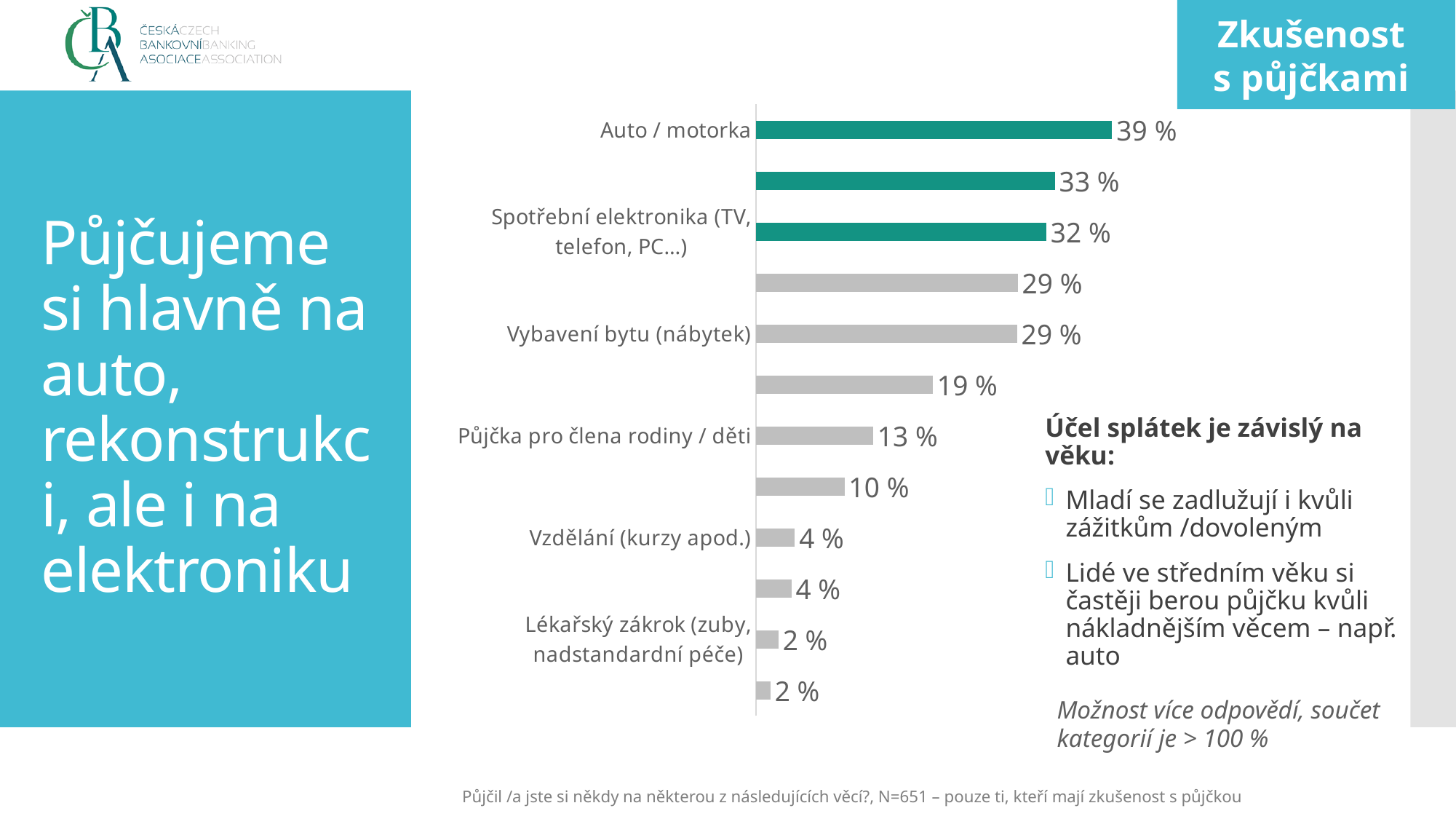
What is the value for Vzdělání (kurzy apod.)? 4 % How many bars are plotted in the chart? 12 How many bars are coloured teal rather than grey? 3 What is the value for Vybavení bytu (nábytek)? 29 % Which category has the highest value? Auto / motorka What is the difference between Auto / motorka and Spotřební elektronika (TV, telefon, PC…)? 7 % What kind of chart is shown on the slide? Bar chart What is the value for Půjčka pro člena rodiny / děti? 13 % What is the value for Auto / motorka? 39 % What is the value for Lékařský zákrok (zuby, nadstandardní péče)? 2 % Which is larger, Vybavení bytu (nábytek) or Půjčka pro člena rodiny / děti? Vybavení bytu (nábytek) What is the value for Spotřební elektronika (TV, telefon, PC…)? 32 %